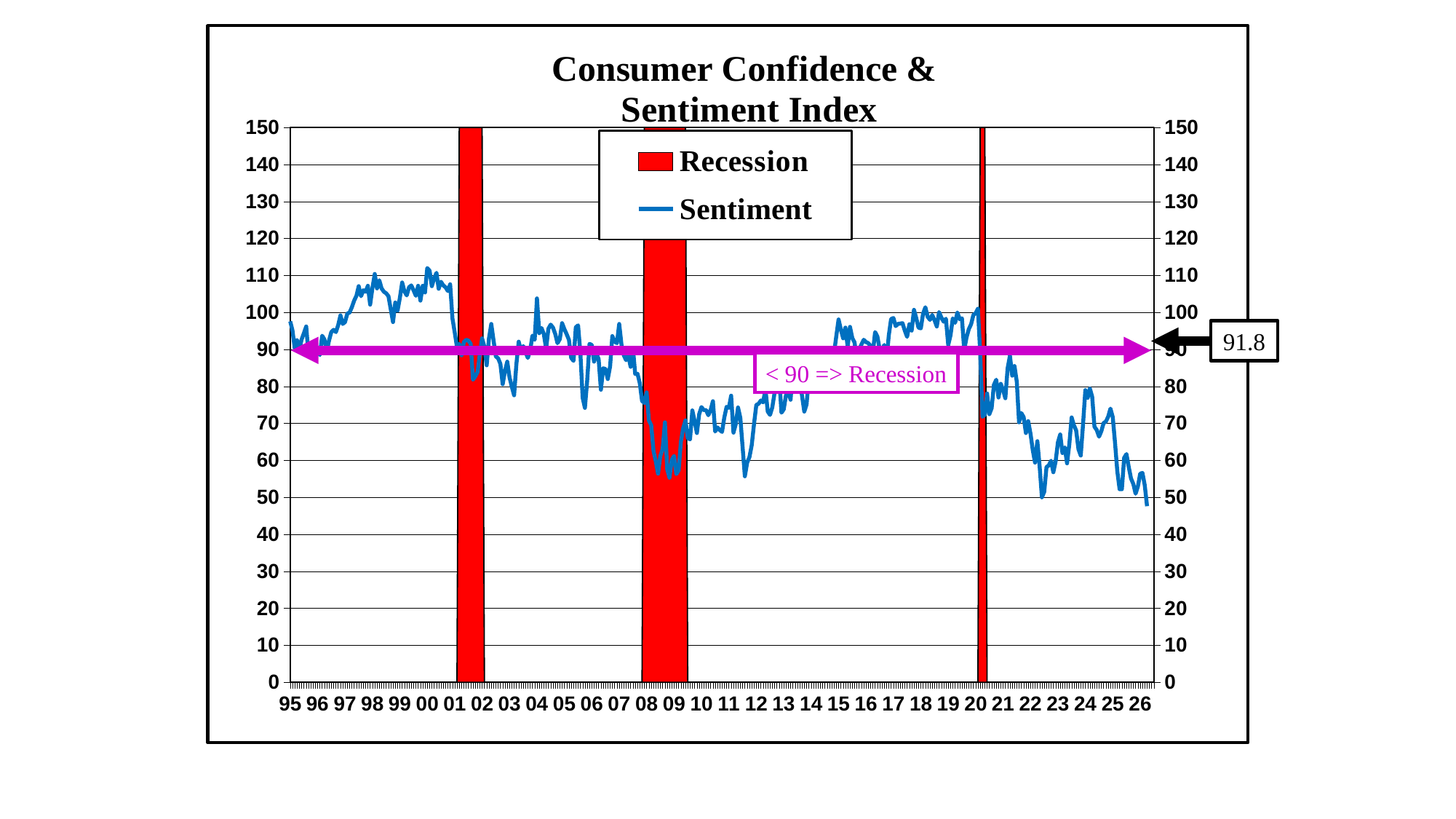
Which is higher, the Sentiment value around 2000 or the Sentiment value around 2009? 2000 How many entries does the chart's legend list? 2 What is the title of the chart? Consumer Confidence & Sentiment Index Is the Sentiment value at the far right end of the line (2026) greater or less than 60? less What is the highest value shown on the vertical axis? 150 Is the Sentiment value at its peak around 2000 greater or less than 100? greater What kind of chart is shown on the slide? line chart Is the Sentiment value around 2012 greater or less than 90? less How many red recession bands are shaded on the chart? 3 Does the Sentiment line generally rise or fall between 2021 and 2026? fall Does the Sentiment line generally rise or fall between 1995 and 2000? rise